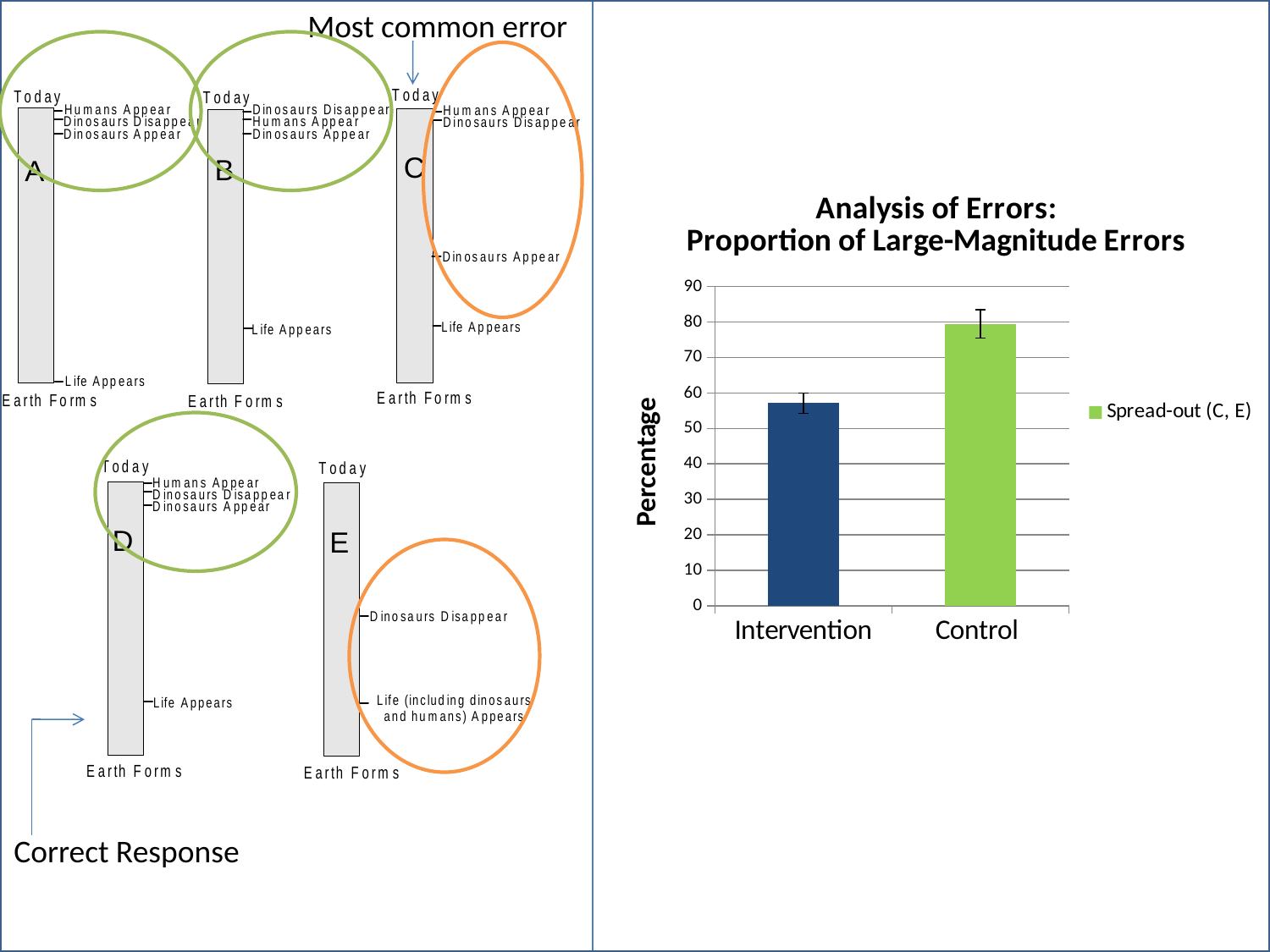
Is the value for Control greater or less than 90? less What is the title of the chart on the right side of the slide? Analysis of Errors: Proportion of Large-Magnitude Errors Is the value for Control greater or less than 70? greater Which is larger in the chart, the value for Intervention or the value for Control? Control Is the value for Intervention greater or less than 60? less What kind of chart is shown on the right side of the slide? bar chart How many series does the chart's legend list? 1 What is the legend entry for the series in the chart? Spread-out (C, E) How many categories are plotted on the x axis of the chart? 2 Which category has the lowest value in the chart? Intervention Which category has the highest value in the chart? Control